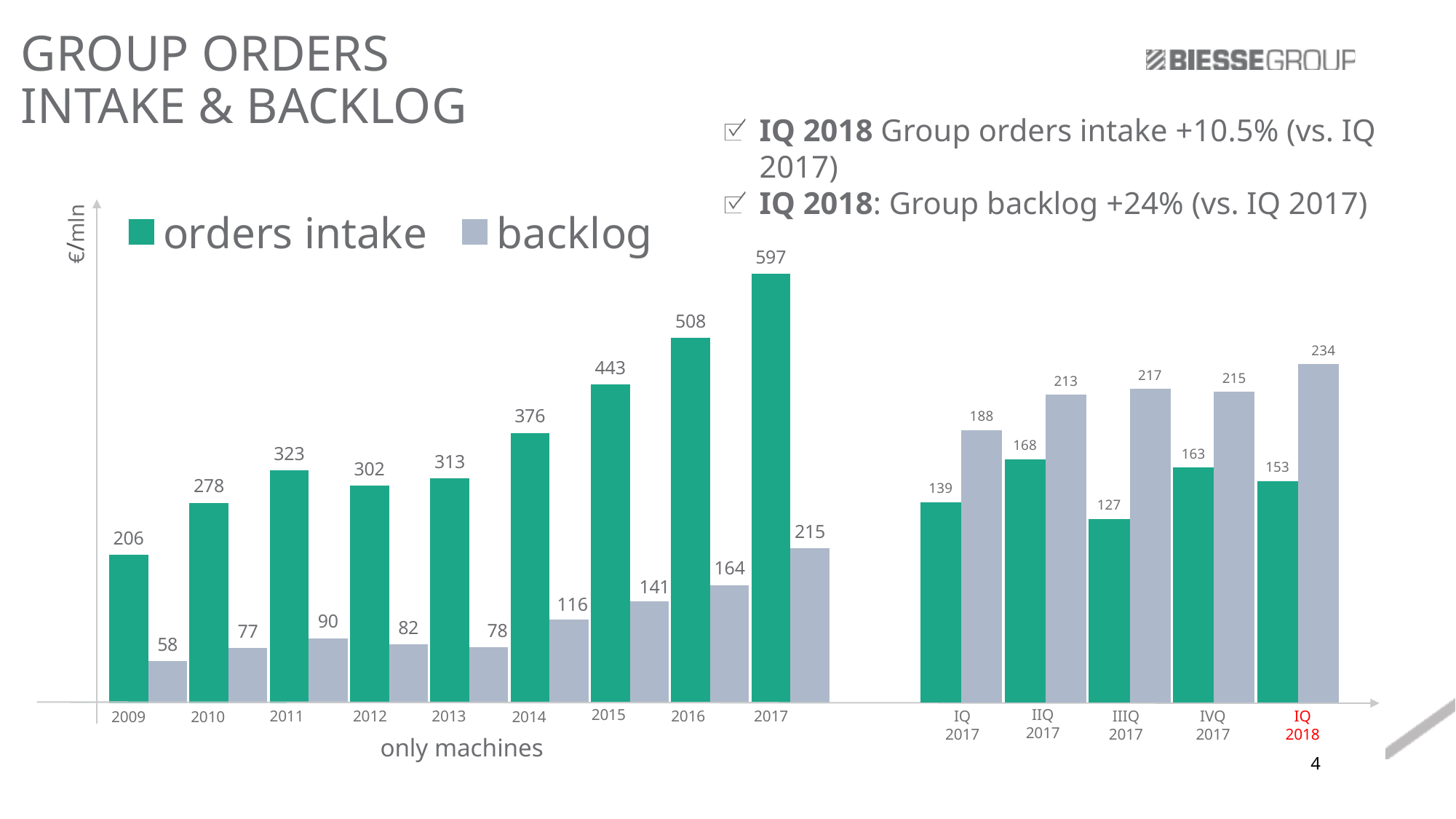
What type of chart is used on this slide? bar chart In the right (quarterly) chart, what is the orders intake value for IIIQ 2017? 127 In the left (annual) chart, what is the orders intake value for 2014? 376 In the left (annual) chart, what is the difference between orders intake in 2017 and 2016? 89 In the left (annual) chart, how many years are shown on the x axis? 9 In the left (annual) chart, what is the backlog value for 2011? 90 In the left (annual) chart, which year has the lowest backlog? 2009 In the left (annual) chart, which year has the highest orders intake? 2017 In the right (quarterly) chart, which quarter has the highest orders intake? IIQ 2017 In the right (quarterly) chart, what is the backlog value for IQ 2018? 234 In the right (quarterly) chart, is the orders intake for IQ 2017 larger or smaller than the backlog for IQ 2017? smaller How many series does the legend list? 2